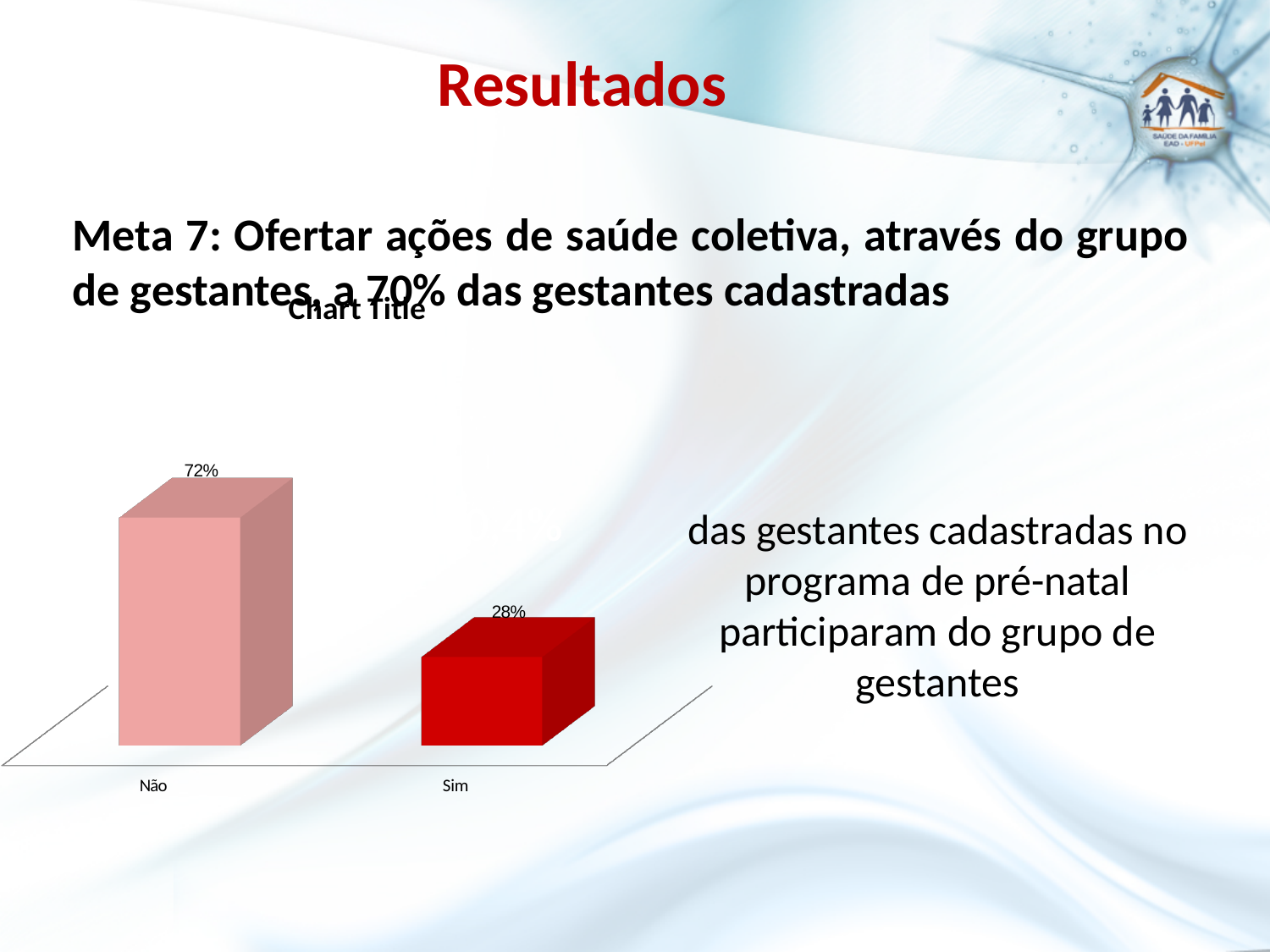
What is the value for "Sim" in the chart? 28% Which category has the highest value in the chart? Não What is the title shown above the chart? Chart Title How many categories are shown in the chart? 2 Which category has the lowest value in the chart? Sim What colour is the bar for "Sim"? Red What is the difference between the values for "Não" and "Sim"? 44% Which is larger, the value for "Não" or the value for "Sim"? Não What is the value for "Não" in the chart? 72% Do the values rise or fall from "Não" to "Sim" along the x axis? Fall What kind of chart is shown on the slide? Bar chart